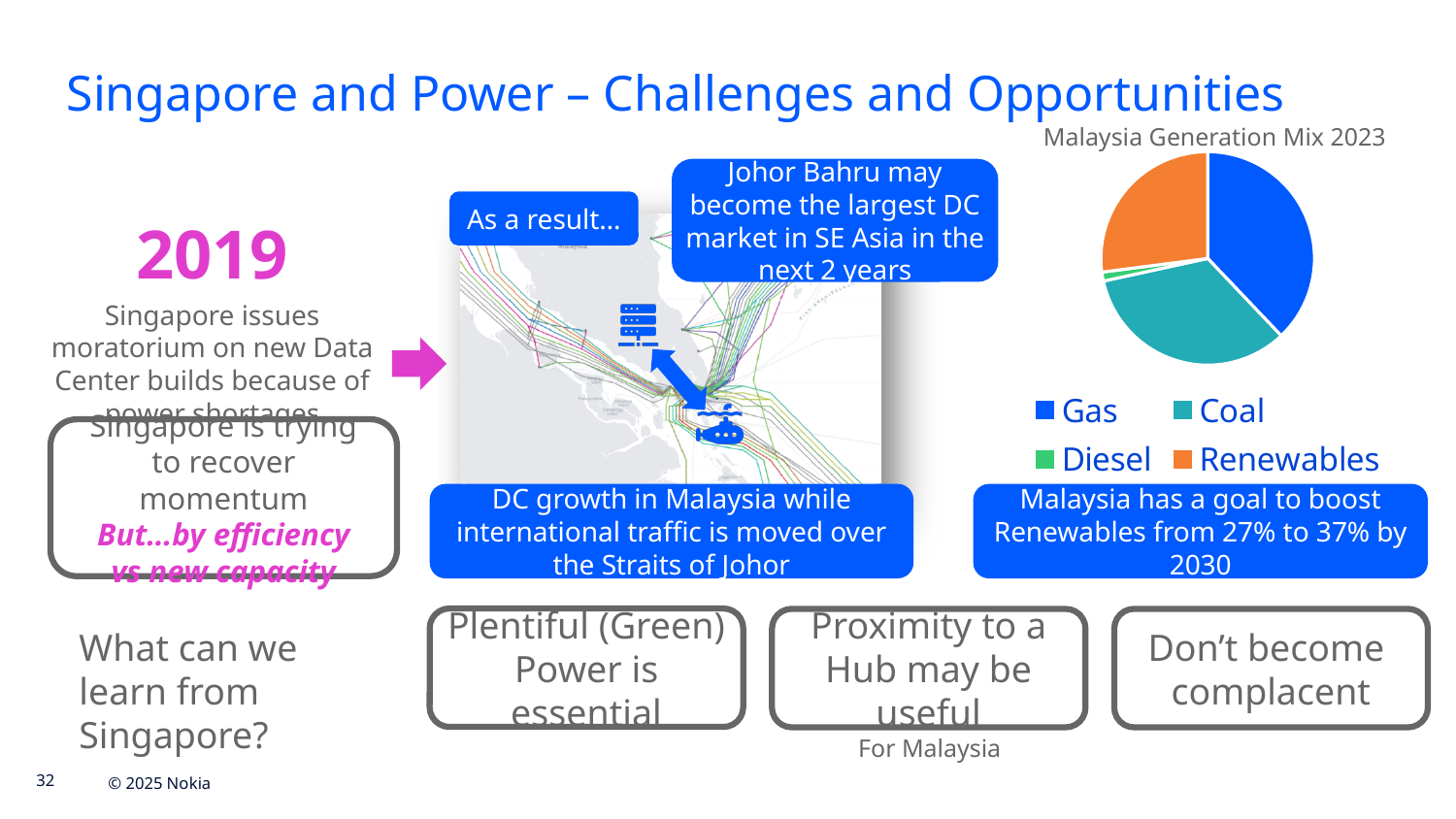
How many categories does the legend of the Malaysia Generation Mix 2023 pie chart list? 4 Which category in the Malaysia Generation Mix 2023 pie chart is shown in teal? Coal In the Malaysia Generation Mix 2023 pie chart, which slice is larger, Coal or Renewables? Coal In the Malaysia Generation Mix 2023 pie chart, which slice is larger, Gas or Coal? Gas What kind of chart is shown under the title "Malaysia Generation Mix 2023"? pie chart Which category has the smallest slice in the Malaysia Generation Mix 2023 pie chart? Diesel Which category has the largest slice in the Malaysia Generation Mix 2023 pie chart? Gas In the Malaysia Generation Mix 2023 pie chart, which slice is larger, Renewables or Diesel? Renewables What is the title of the pie chart on the slide? Malaysia Generation Mix 2023 What colour represents Renewables in the Malaysia Generation Mix 2023 pie chart? orange